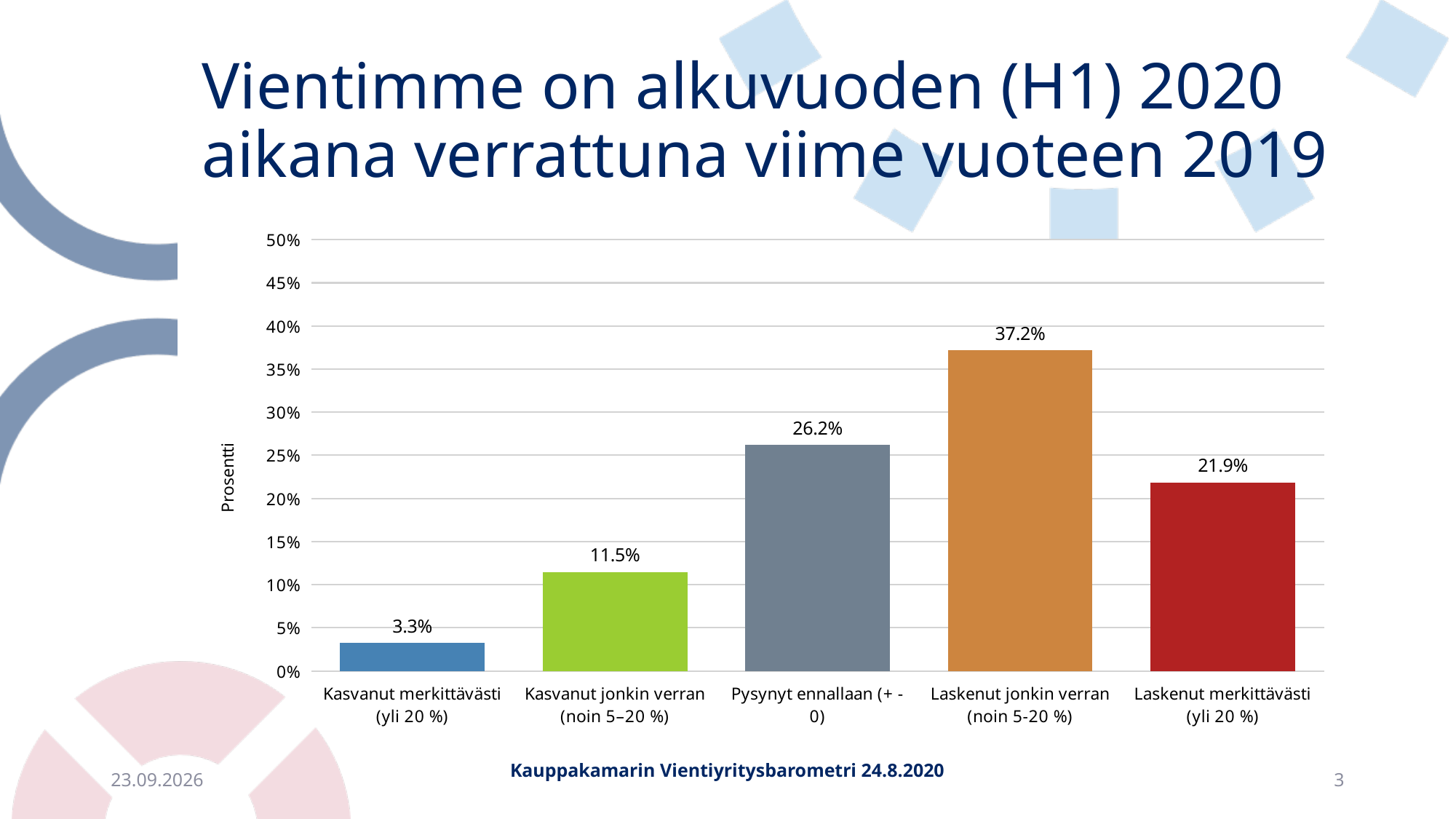
What is the value for "Kasvanut merkittävästi (yli 20 %)"? 3.3% What kind of chart is shown on the slide? bar chart What is the value for "Pysynyt ennallaan (+ - 0)"? 26.2% How many categories are shown on the x axis? 5 Which is larger: the value for "Kasvanut jonkin verran (noin 5–20 %)" or the value for "Laskenut merkittävästi (yli 20 %)"? Laskenut merkittävästi (yli 20 %) What colour is the bar for "Kasvanut jonkin verran (noin 5–20 %)"? green What is the label of the y axis? Prosentti Is the value for "Pysynyt ennallaan (+ - 0)" greater or less than 25%? greater Which category has the lowest value? Kasvanut merkittävästi (yli 20 %) What is the value for "Laskenut jonkin verran (noin 5-20 %)"? 37.2% Which category has the highest value? Laskenut jonkin verran (noin 5-20 %) What is the difference between the values for "Laskenut jonkin verran (noin 5-20 %)" and "Laskenut merkittävästi (yli 20 %)"? 15.3%